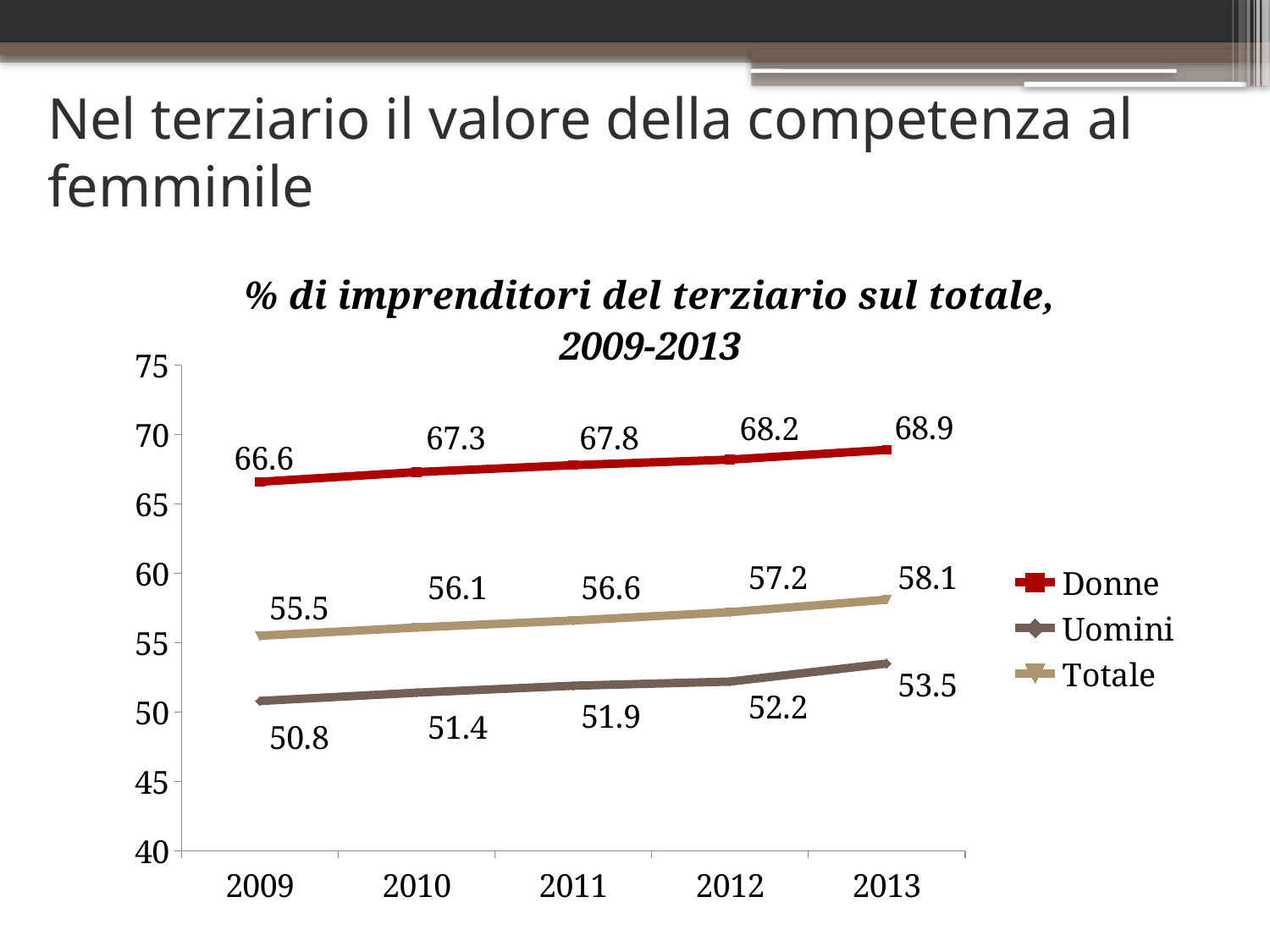
What is the value for Totale in 2011? 56.6 How many years are shown on the x axis? 5 How many series does the legend list? 3 What is the value for Donne in 2013? 68.9 What is the value for Uomini in 2009? 50.8 What kind of chart is this? line chart What is the title of the chart? % di imprenditori del terziario sul totale, 2009-2013 Does the Totale series rise or fall from 2009 to 2013? rise In which year is the Uomini series lowest? 2009 In which year is the Donne series highest? 2013 Which is larger in 2010, Donne or Totale? Donne What is the difference between Donne and Uomini in 2013? 15.4